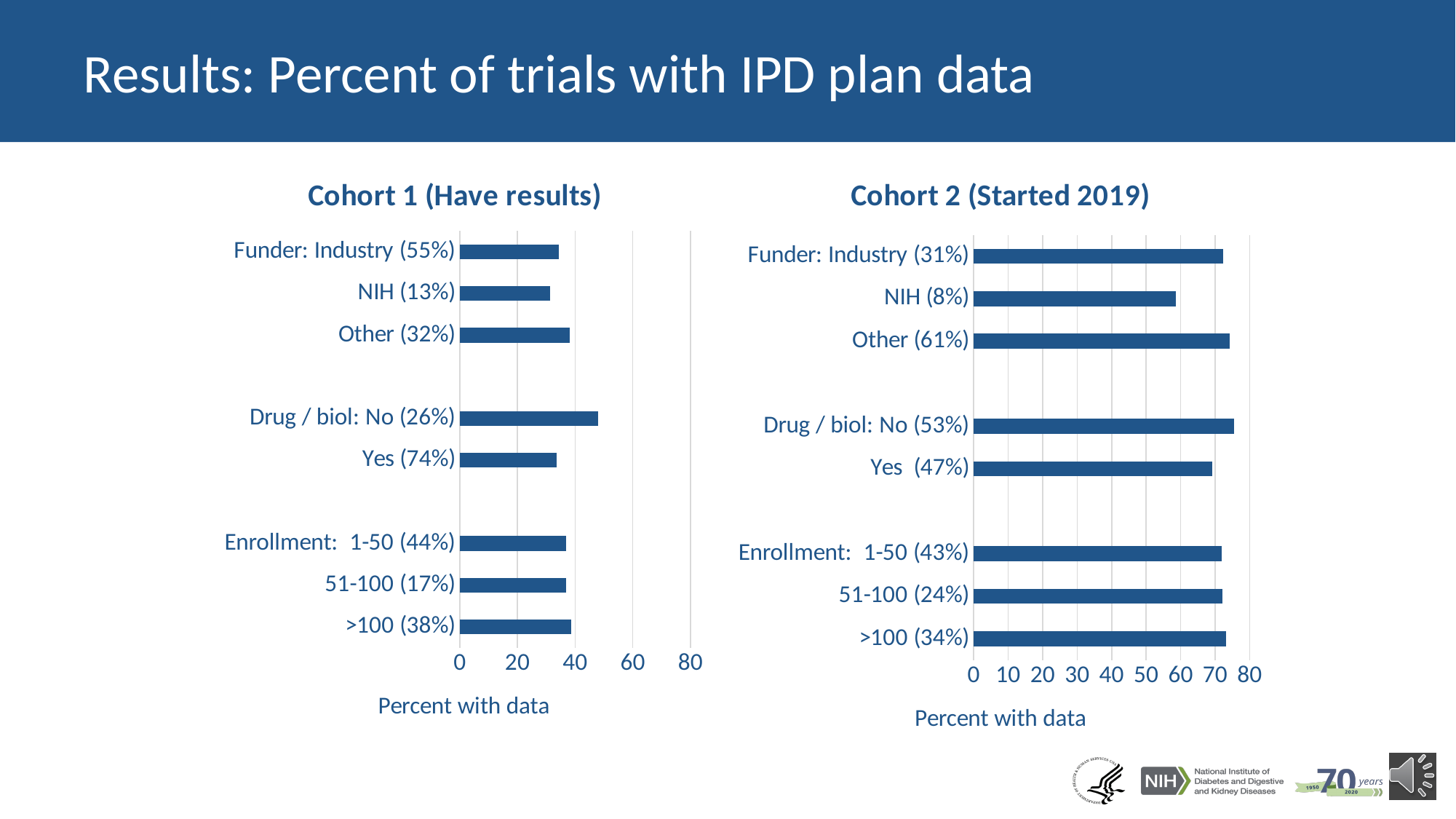
In the Cohort 2 (Started 2019) chart, which category has the lowest percent with data? NIH (8%) In the Cohort 2 (Started 2019) chart, is the value for NIH (8%) greater or less than 50? greater In the Cohort 2 (Started 2019) chart, which has a larger value: Funder: Industry (31%) or NIH (8%)? Funder: Industry (31%) In the Cohort 1 (Have results) chart, is the value for Drug / biol: No (26%) greater or less than 40? greater What is the x-axis title of the Cohort 1 (Have results) chart? Percent with data What kind of chart is the Cohort 1 (Have results) chart? bar chart What is the title of the chart on the right side of the slide? Cohort 2 (Started 2019) How many categories (bars) are shown in the Cohort 2 (Started 2019) chart? 8 In the Cohort 1 (Have results) chart, is the value for NIH (13%) greater or less than 40? less In the Cohort 1 (Have results) chart, which has a larger value: Drug / biol: No (26%) or Yes (74%)? Drug / biol: No (26%) In the Cohort 1 (Have results) chart, which category has the highest percent with data? Drug / biol: No (26%)